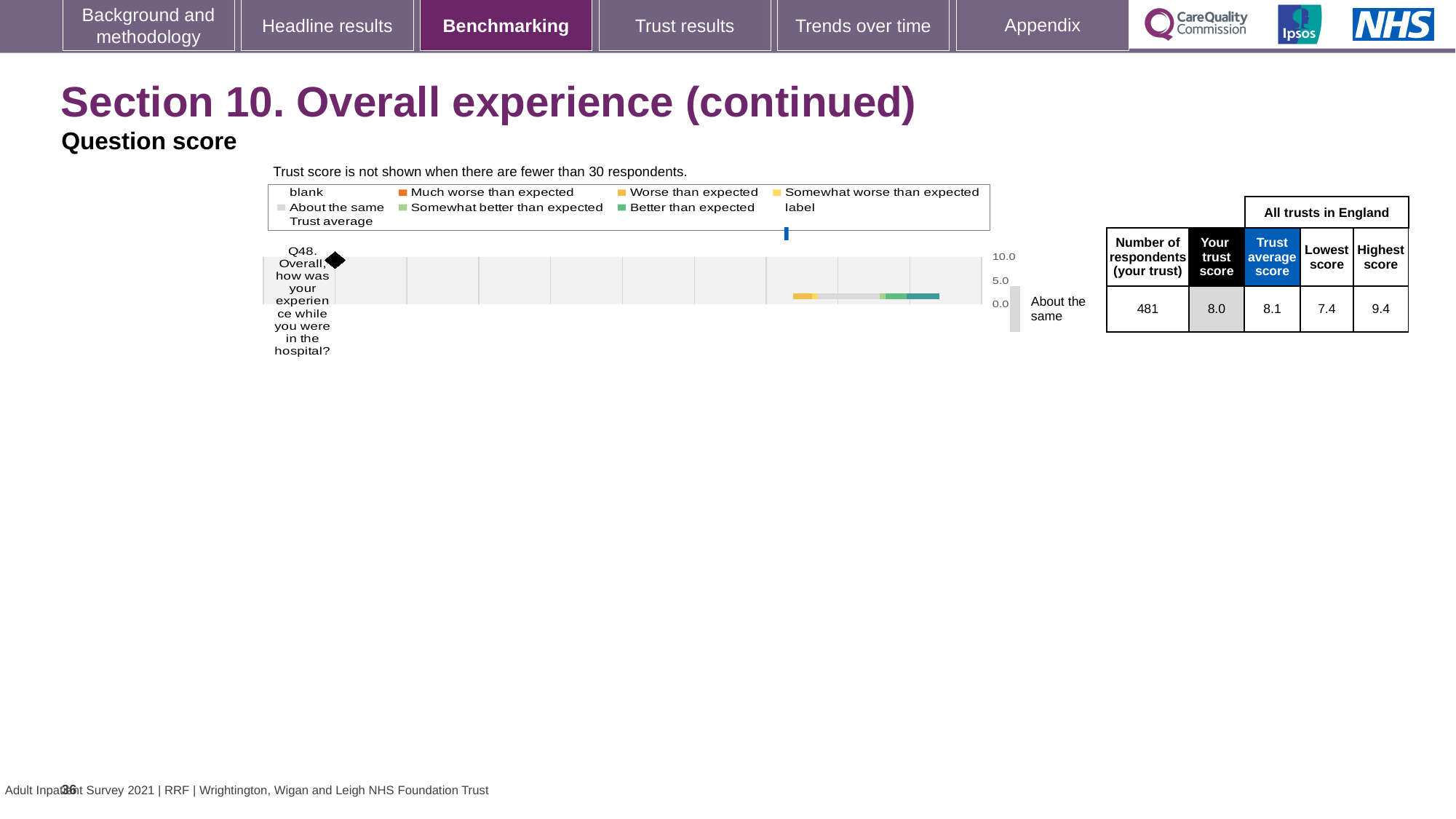
What is your trust score for Q48? 8.0 What kind of chart is used to show the Q48 benchmarking result? bar chart Is your trust score for Q48 greater or less than 5.0? greater What is the number of respondents (your trust) for Q48? 481 How many questions are plotted on the chart? 1 What is the highest score for Q48 across all trusts in England? 9.4 What is the trust average score for Q48 across all trusts in England? 8.1 According to the legend, what does the orange colour represent? Much worse than expected What is the difference between the highest score and the lowest score for Q48? 2.0 What is the lowest score for Q48 across all trusts in England? 7.4 What benchmark category is shown next to the Q48 bar? About the same Which is larger for Q48: your trust score or the trust average score? Trust average score